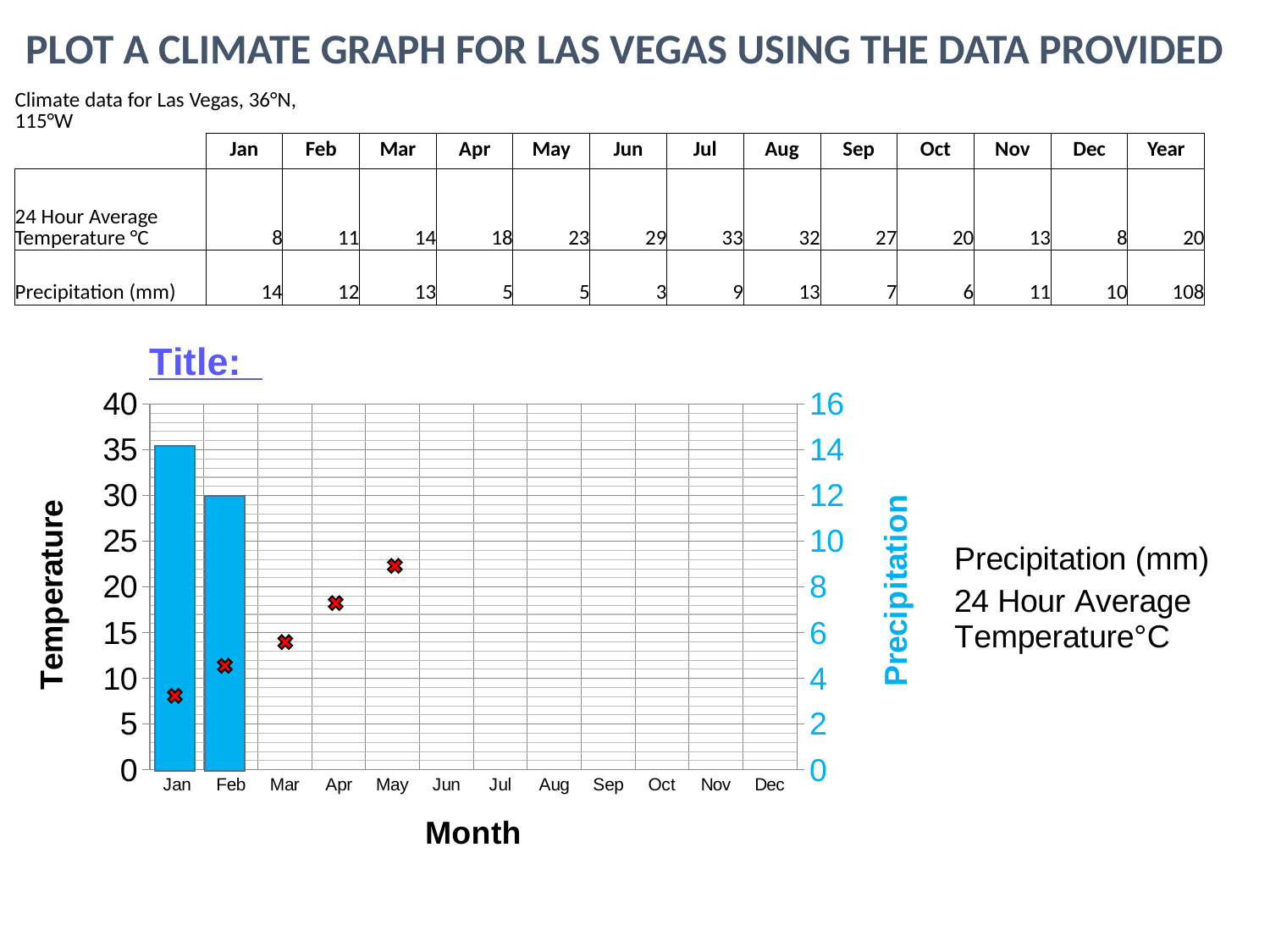
Is the plotted temperature point for Jan greater or less than 10 on the left axis? less Is the plotted temperature point for May greater or less than 20 on the left axis? greater What value on the right-hand Precipitation axis does the Feb bar reach? 12 What is the difference between the Jan and Feb precipitation bars on the right-hand axis? 2 What is the title of the x axis of the chart? Month Do the plotted temperature points rise or fall from Jan to May? rise What value on the right-hand Precipitation axis does the Jan bar reach? 14 How many series does the chart legend list? 2 How many months are shown along the x axis of the chart? 12 How many temperature points have been plotted on the chart? 5 Which plotted precipitation bar is taller, Jan or Feb? Jan For how many months has a precipitation bar been plotted on the chart? 2